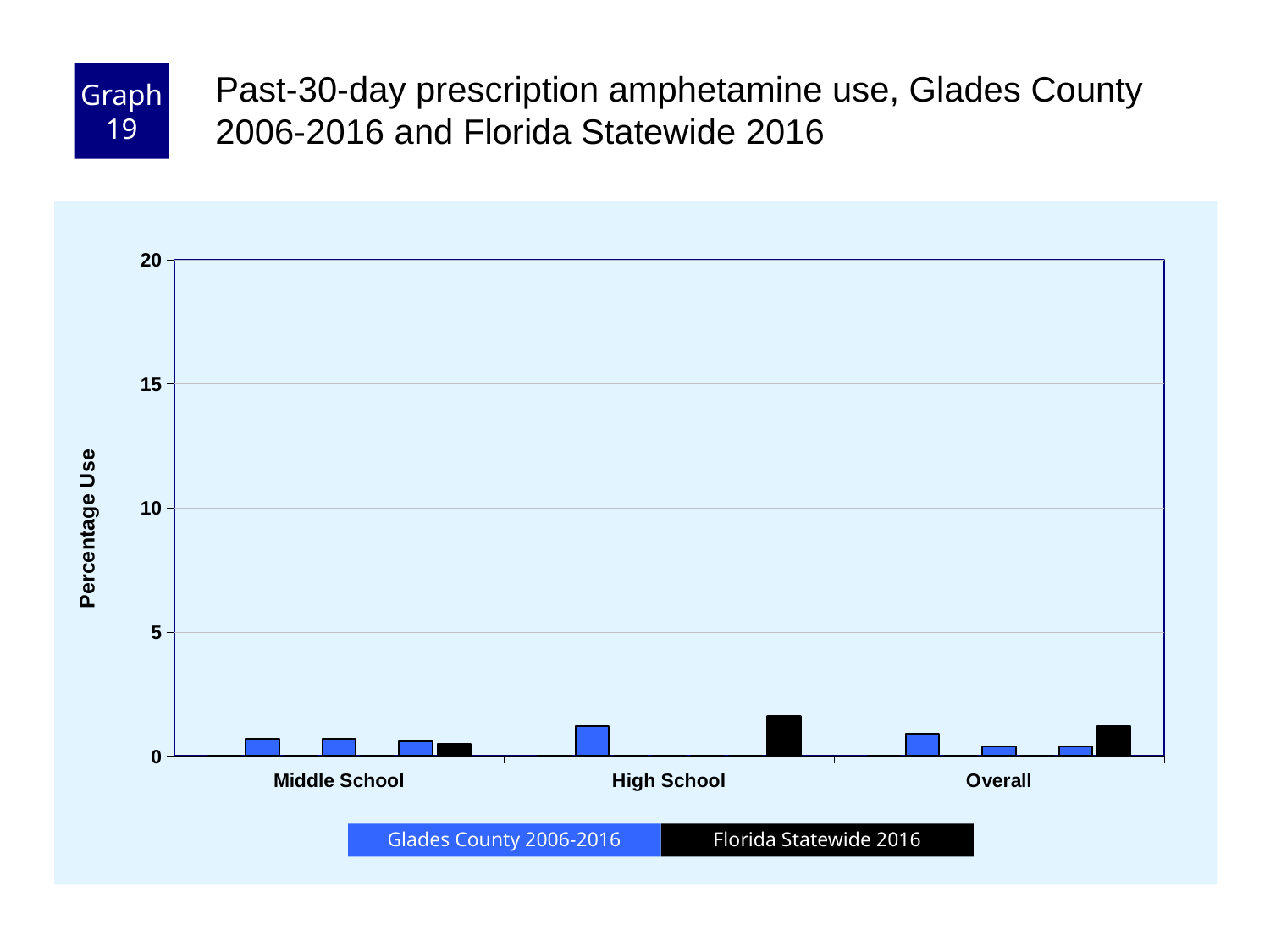
Is the Florida Statewide 2016 value larger for High School or for Middle School? High School Is the Florida Statewide 2016 value for Overall greater or less than 5? less Which series is shown in black in the chart? Florida Statewide 2016 Is the Florida Statewide 2016 value for High School greater or less than 5? less Which category has the highest Florida Statewide 2016 value? High School Which category has the lowest Florida Statewide 2016 value? Middle School How many series does the chart's legend list? 2 How many categories are shown on the x axis of the chart? 3 Is the Florida Statewide 2016 value for Middle School greater or less than 5? less Is the Florida Statewide 2016 value larger for Overall or for Middle School? Overall What is the label on the y axis of the chart? Percentage Use What kind of chart is shown on the slide? bar chart